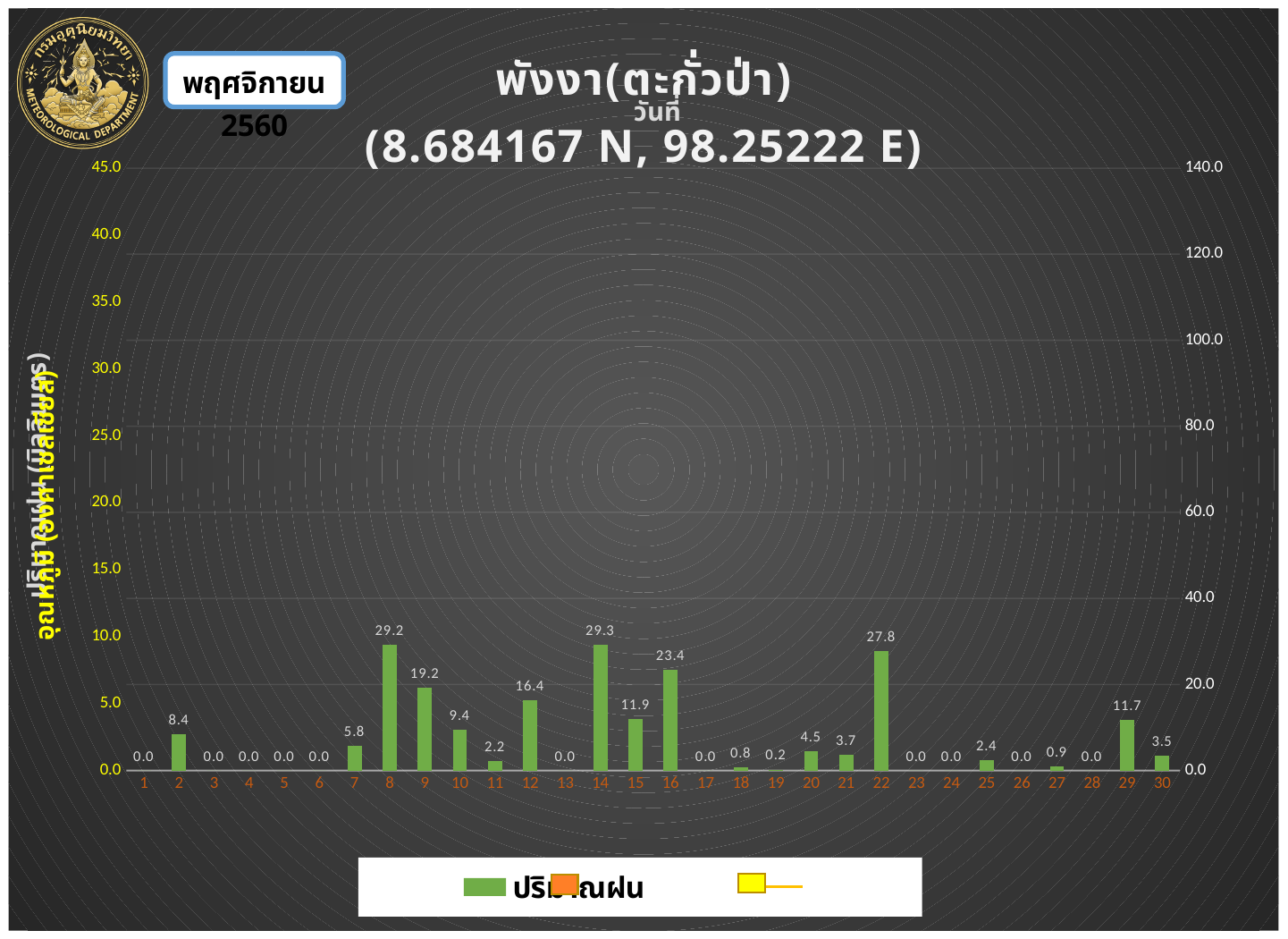
What is the rainfall value shown for day 29? 11.7 How many days are shown on the x axis of the chart? 30 Which day has the larger rainfall value, day 9 or day 10? day 9 What kind of chart is shown on the slide? bar chart Which day has the larger rainfall value, day 22 or day 16? day 22 What is the rainfall value shown for day 16? 23.4 What is the difference between the rainfall values for day 16 and day 15? 11.5 What is the rainfall value shown for day 8? 29.2 What coordinates are given in the chart title? 8.684167 N, 98.25222 E Which day has the highest rainfall value on the chart? 14 What is the difference between the rainfall values for day 14 and day 8? 0.1 What is the rainfall value shown for day 22? 27.8